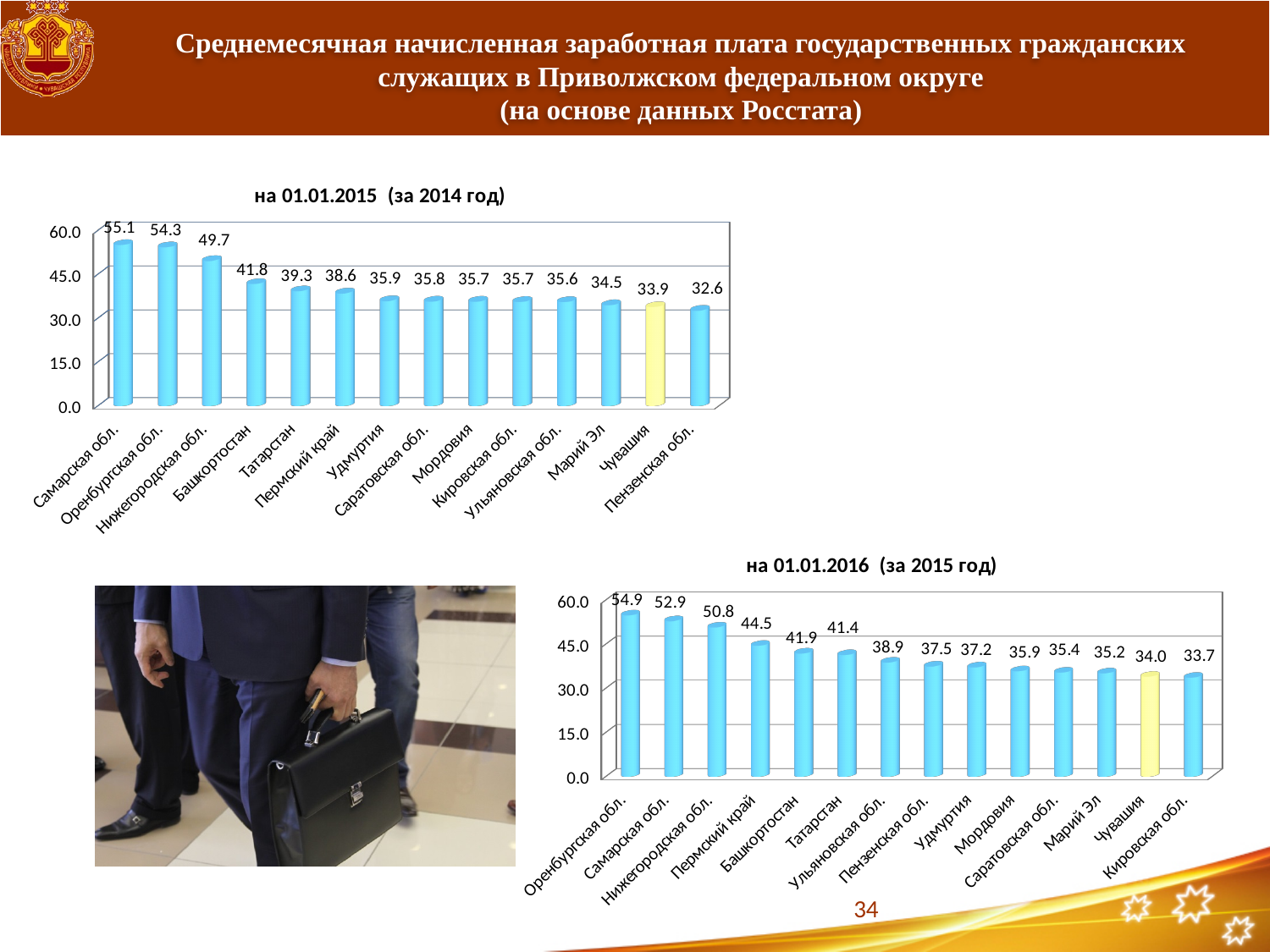
What type of chart is the bottom chart (на 01.01.2016 (за 2015 год))? bar chart In the bottom chart (на 01.01.2016 (за 2015 год)), what is the value for Оренбургская обл.? 54.9 In the bottom chart (на 01.01.2016 (за 2015 год)), which is larger, the value for Пермский край or the value for Башкортостан? Пермский край In the bottom chart (на 01.01.2016 (за 2015 год)), is the value for Нижегородская обл. greater or less than 45.0? greater In the top chart (на 01.01.2015 (за 2014 год)), what is the difference between the values for Самарская обл. and Чувашия? 21.2 In the top chart (на 01.01.2015 (за 2014 год)), how many regions are shown? 14 In the top chart (на 01.01.2015 (за 2014 год)), which region has the lowest value? Пензенская обл. In the top chart (на 01.01.2015 (за 2014 год)), which region has the highest value? Самарская обл. In the top chart (на 01.01.2015 (за 2014 год)), do the values rise or fall from left to right? fall In the top chart (на 01.01.2015 (за 2014 год)), what is the value for Чувашия? 33.9 In the bottom chart (на 01.01.2016 (за 2015 год)), which region has the lowest value? Кировская обл. In the bottom chart (на 01.01.2016 (за 2015 год)), what is the difference between the values for Чувашия and Кировская обл.? 0.3